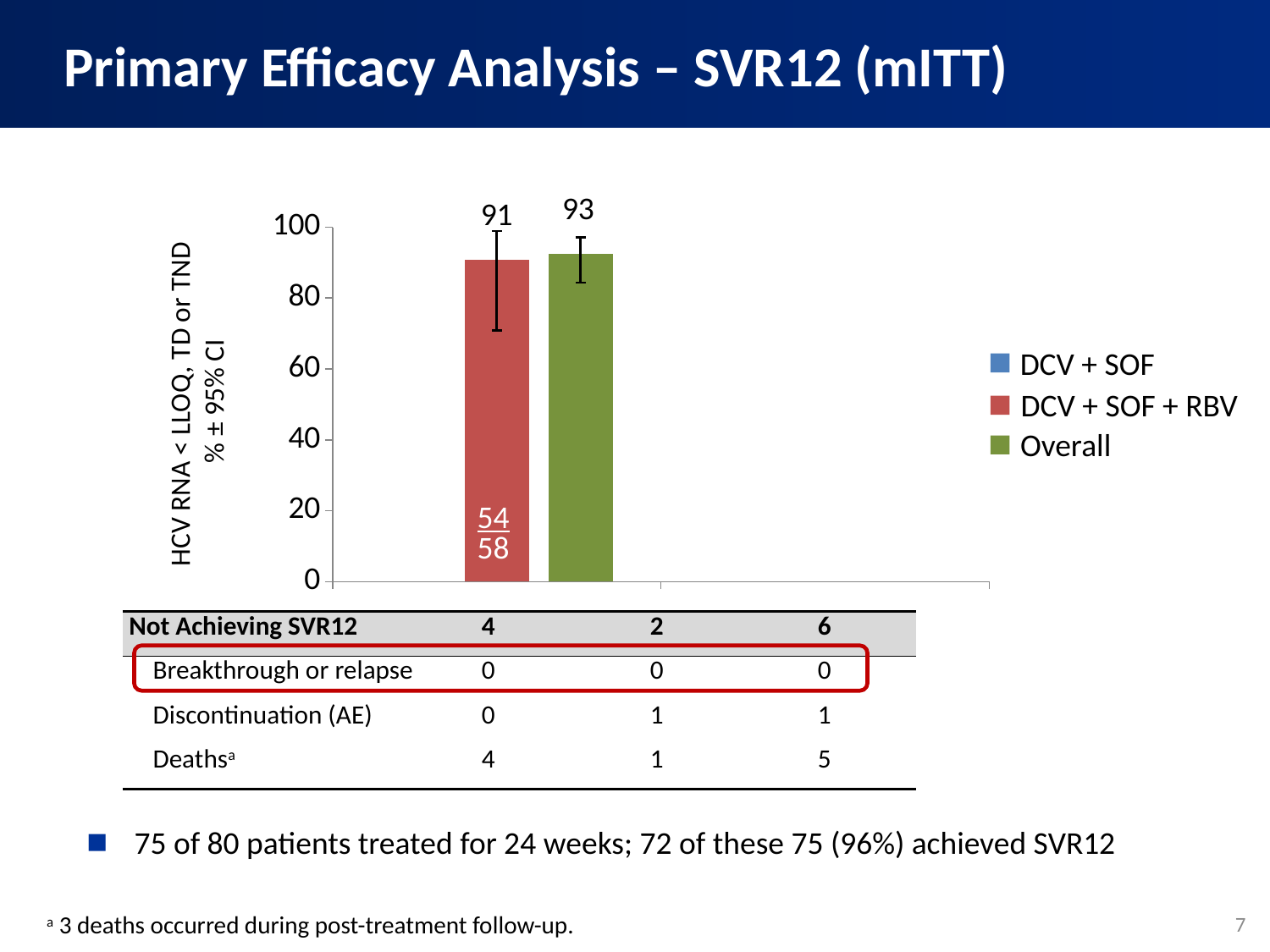
What is the SVR12 value shown for Overall? 93 What fraction is printed on the DCV + SOF + RBV bar? 54/58 What is the SVR12 value shown for DCV + SOF + RBV? 91 What colour is the Overall series in the legend? green What kind of chart is shown on the slide? bar chart What is the label on the y axis of the chart? HCV RNA < LLOQ, TD or TND % ± 95% CI What is the difference between the Overall value and the DCV + SOF + RBV value? 2 How many series does the legend list? 3 Is the value for DCV + SOF + RBV greater or less than 80? greater How many bars are plotted in the chart? 2 Which plotted bar has the highest value? Overall Which is larger, the value for Overall or the value for DCV + SOF + RBV? Overall